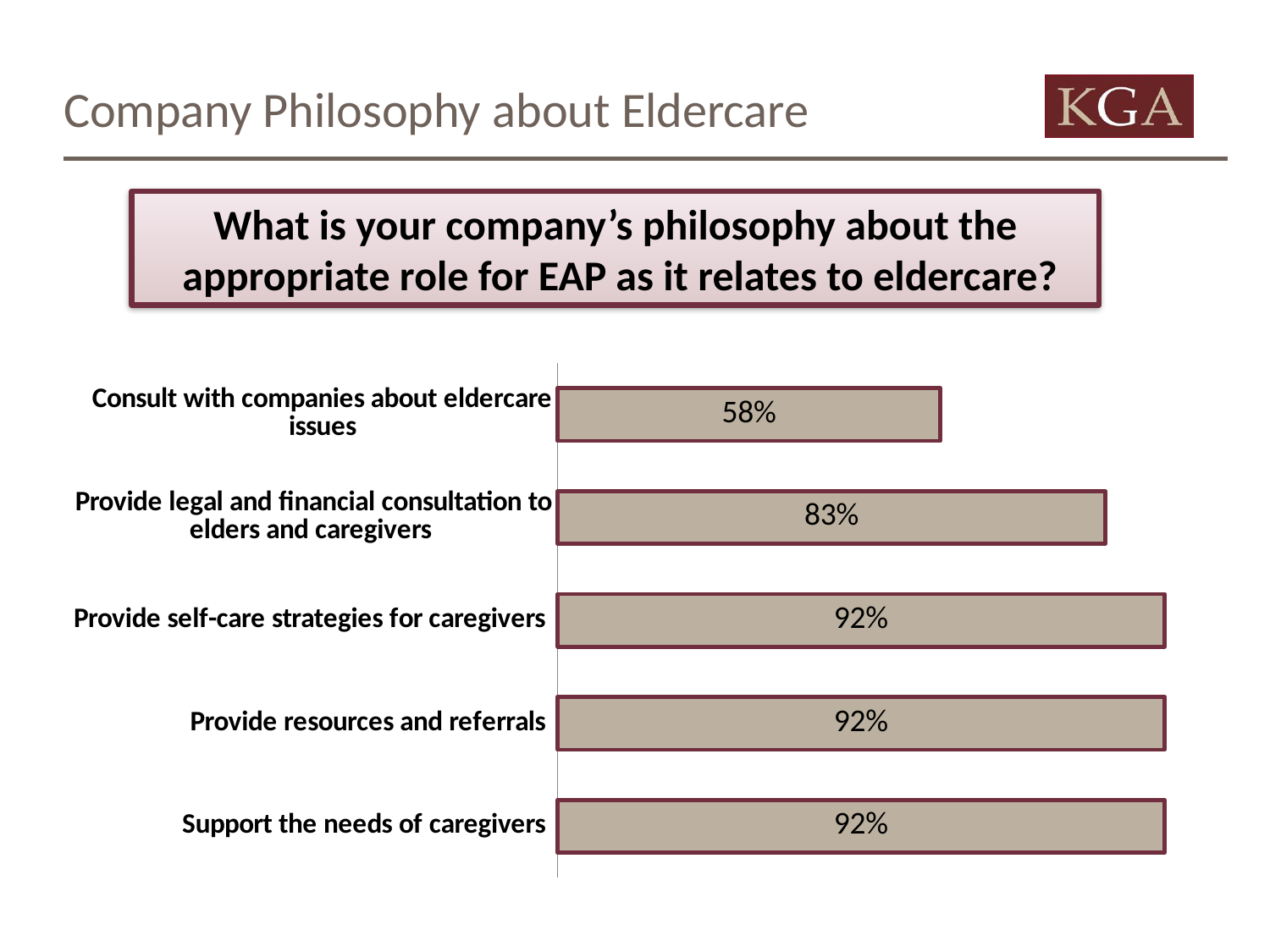
What question does the chart on the slide answer? What is your company's philosophy about the appropriate role for EAP as it relates to eldercare? Which category has the lowest value? Consult with companies about eldercare issues How many categories have a value of 92%? 3 How many categories are shown in the chart? 5 What is the difference between the values for "Provide resources and referrals" and "Provide legal and financial consultation to elders and caregivers"? 9% Which is larger: the value for "Provide legal and financial consultation to elders and caregivers" or the value for "Consult with companies about eldercare issues"? Provide legal and financial consultation to elders and caregivers What is the value for "Support the needs of caregivers"? 92% What kind of chart is shown on the slide? Bar chart What is the difference between the values for "Provide self-care strategies for caregivers" and "Consult with companies about eldercare issues"? 34% What is the value for "Consult with companies about eldercare issues"? 58% What is the value for "Provide resources and referrals"? 92% What is the value for "Provide legal and financial consultation to elders and caregivers"? 83%